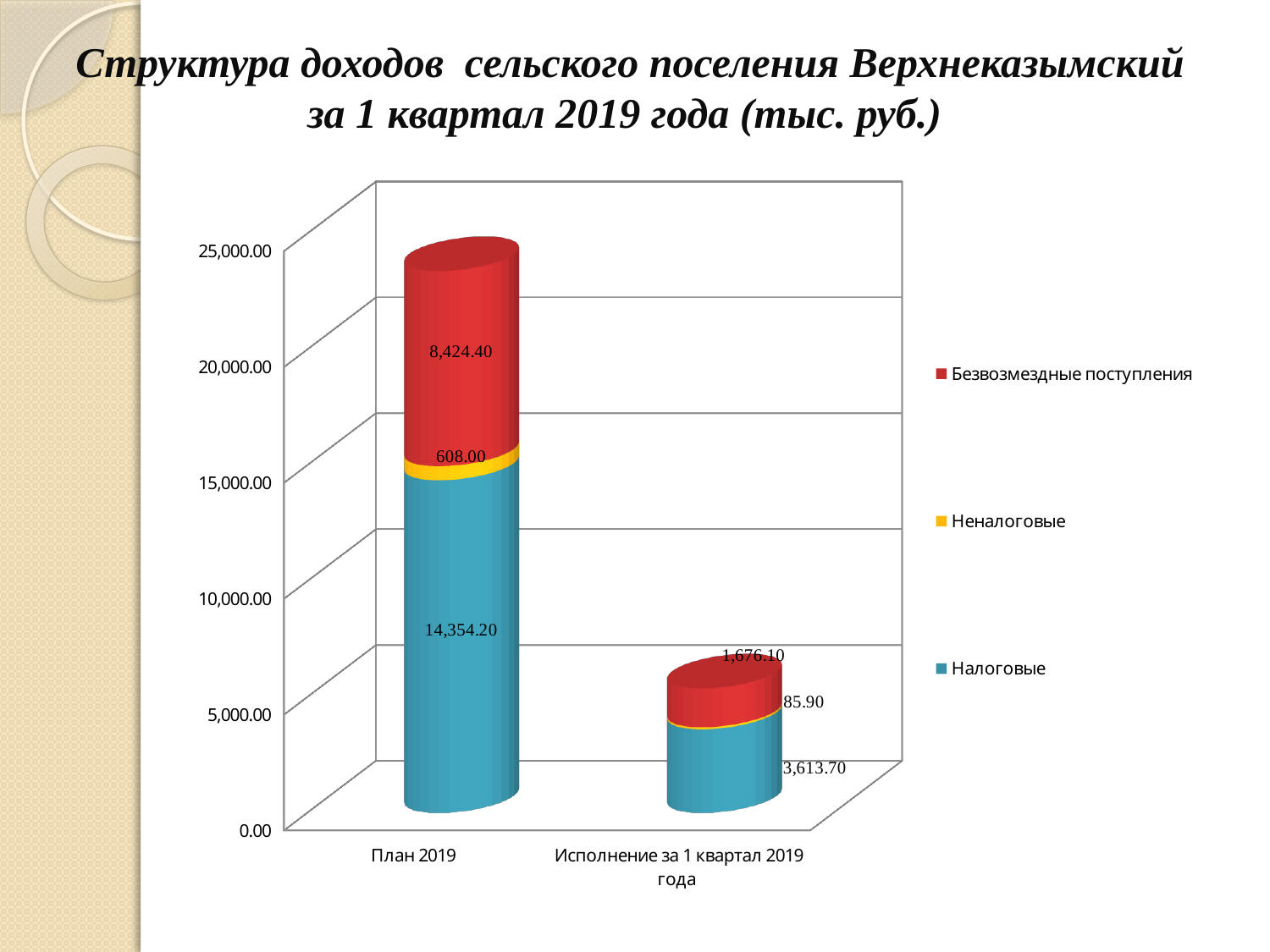
What is the total of the stacked bar for План 2019? 23,386.60 What is the total of the stacked bar for Исполнение за 1 квартал 2019 года? 5,375.70 Which series has the largest value in the План 2019 bar? Налоговые Which series is shown in red in the legend? Безвозмездные поступления What is the value of Налоговые for План 2019? 14,354.20 What is the value of Безвозмездные поступления for Исполнение за 1 квартал 2019 года? 1,676.10 How many series does the legend list? 3 What is the value of Неналоговые for План 2019? 608.00 What is the value of Неналоговые for Исполнение за 1 квартал 2019 года? 85.90 What is the difference between the Налоговые values for План 2019 and Исполнение за 1 квартал 2019 года? 10,740.50 What type of chart is shown on the slide? Stacked bar chart How many categories are shown on the x axis? 2